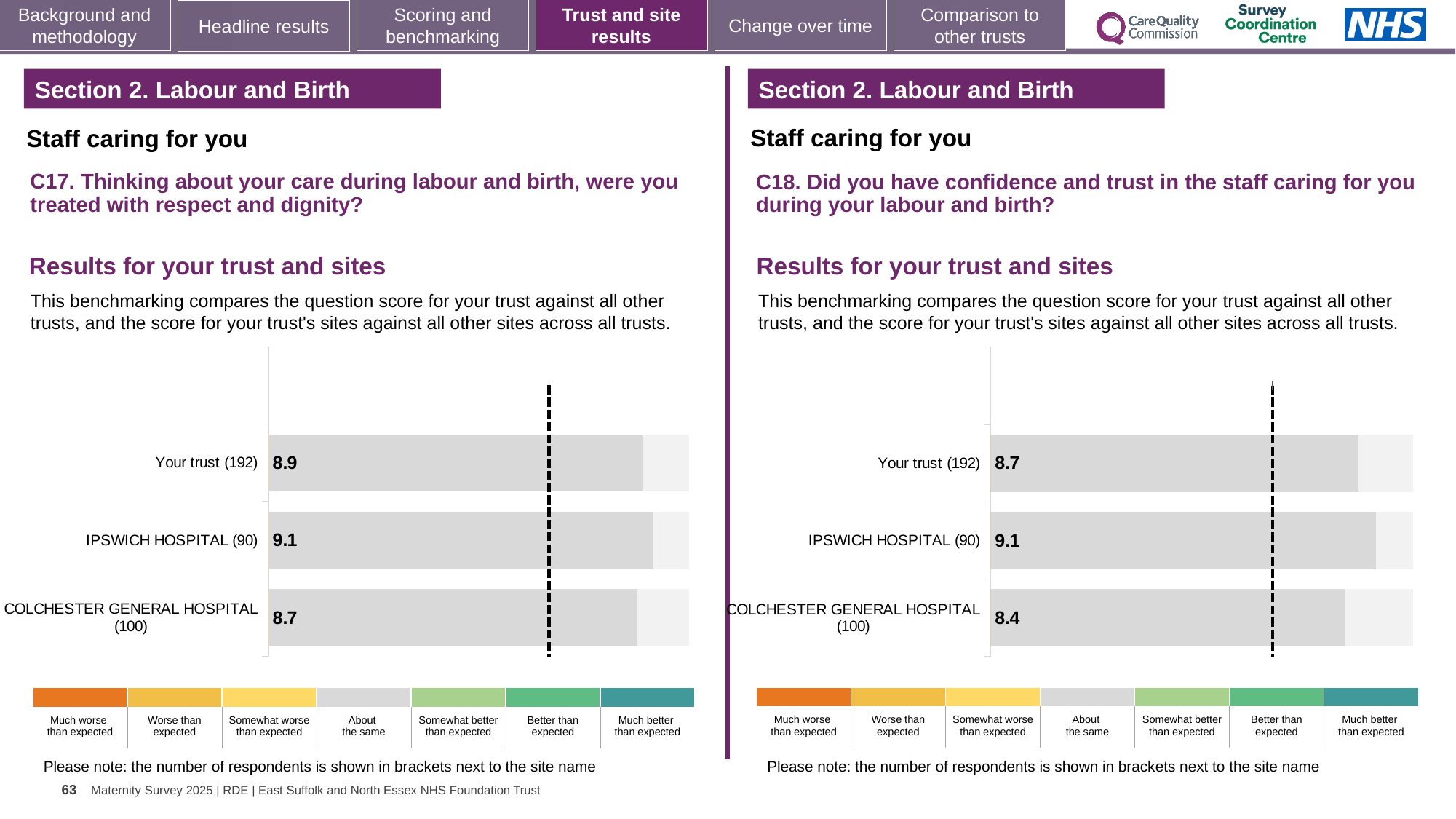
In the C18 chart (confidence and trust in staff), what is the score for COLCHESTER GENERAL HOSPITAL? 8.4 In the C17 chart (treated with respect and dignity), what is the score for COLCHESTER GENERAL HOSPITAL? 8.7 In the C17 chart (treated with respect and dignity), what is the difference between the IPSWICH HOSPITAL score and the COLCHESTER GENERAL HOSPITAL score? 0.4 In the C17 chart (treated with respect and dignity), what is the score for IPSWICH HOSPITAL? 9.1 In the C18 chart (confidence and trust in staff), which site or trust has the lowest score? COLCHESTER GENERAL HOSPITAL In the C18 chart (confidence and trust in staff), which has the larger score, IPSWICH HOSPITAL or Your trust? IPSWICH HOSPITAL In the C18 chart (confidence and trust in staff), what is the score for Your trust? 8.7 In the C18 chart (confidence and trust in staff), what is the difference between the IPSWICH HOSPITAL score and the Your trust score? 0.4 How many bars are plotted in the C17 chart (treated with respect and dignity)? 3 What kind of chart is used in the C18 chart (confidence and trust in staff)? Bar chart In the C17 chart (treated with respect and dignity), what is the score for Your trust? 8.9 In the C17 chart (treated with respect and dignity), which site or trust has the highest score? IPSWICH HOSPITAL